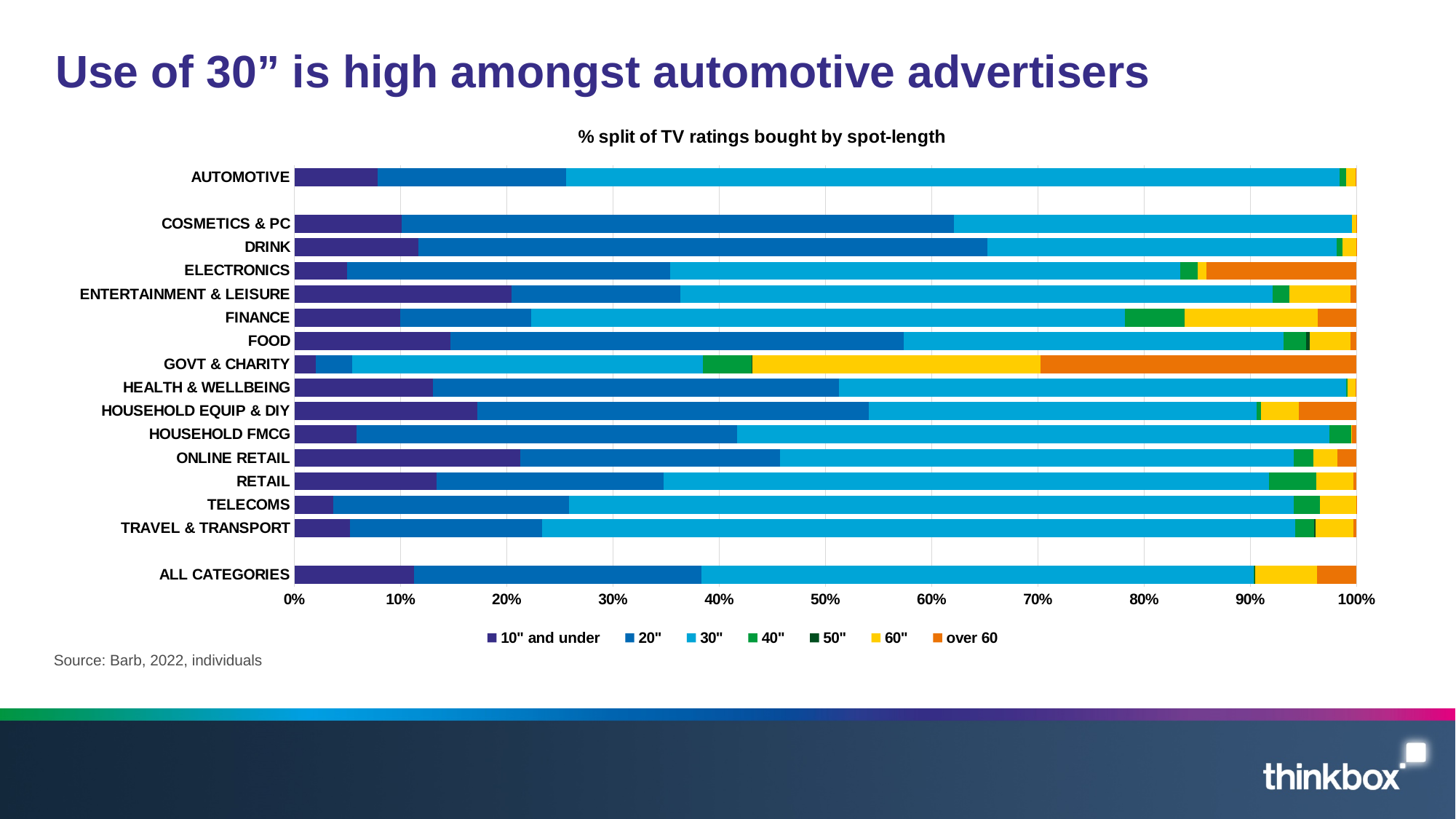
Which category has the largest 60" segment? GOVT & CHARITY What is the title of the chart? % split of TV ratings bought by spot-length Which has the larger 'over 60' segment, ELECTRONICS or FINANCE? ELECTRONICS What kind of chart is shown on the slide? Bar chart How many category bars are plotted in the chart, including ALL CATEGORIES? 16 Is the '10" and under' share for ELECTRONICS greater or less than 10%? less How many series does the legend list? 7 Is the '10" and under' share for FOOD greater or less than 10%? greater Is the '10" and under' share for HOUSEHOLD EQUIP & DIY greater or less than 20%? less Which category has the smallest '10" and under' segment? GOVT & CHARITY Which category has the largest 'over 60' segment? GOVT & CHARITY Which has the larger '10" and under' segment, FOOD or TELECOMS? FOOD